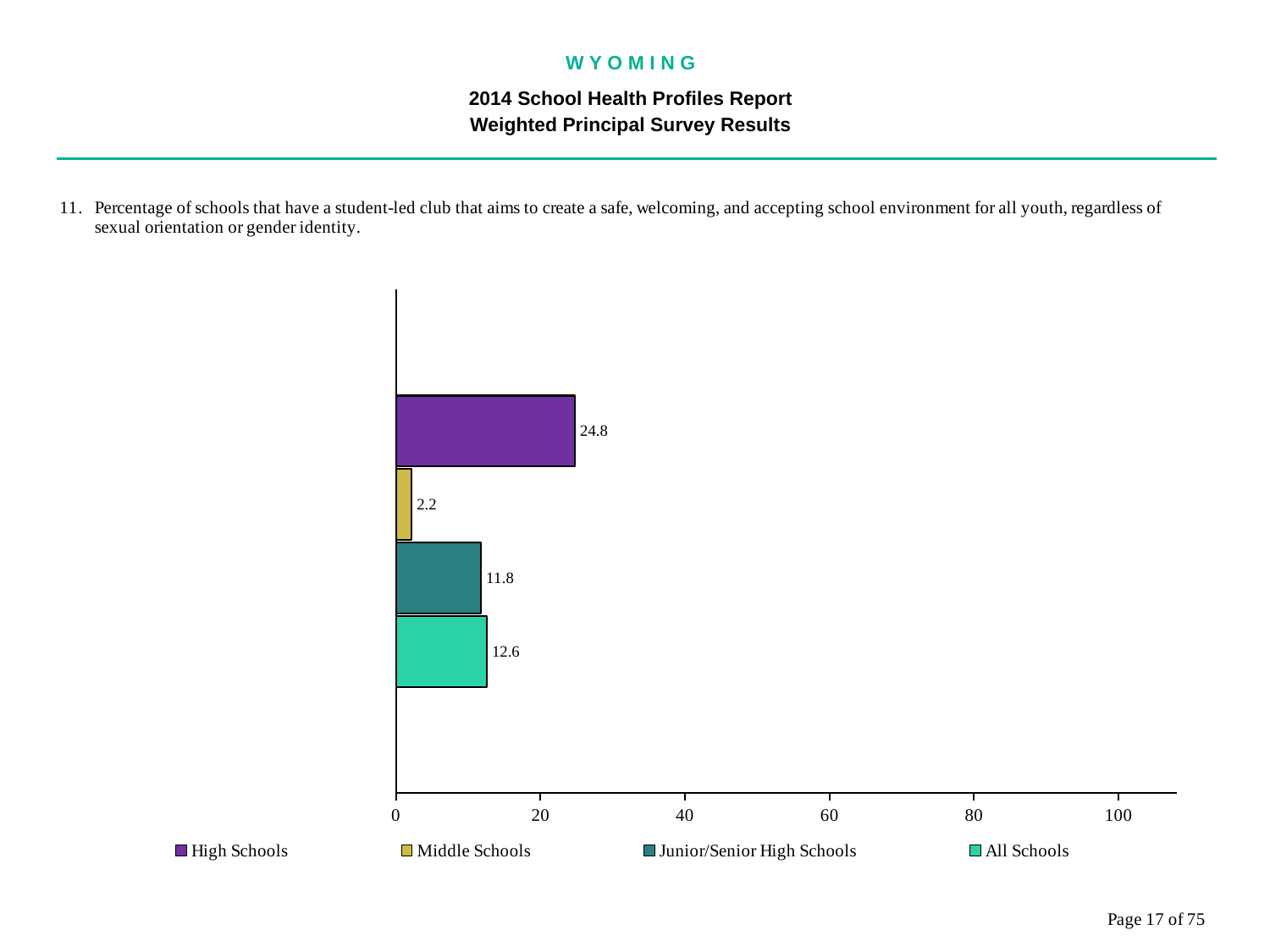
Which school type has the highest value? High Schools Is the value for High Schools greater or less than 20? greater What is the value for Junior/Senior High Schools? 11.8 What is the value for All Schools? 12.6 What is the value for High Schools? 24.8 What kind of chart is shown on the slide? bar chart What is the value for Middle Schools? 2.2 Which school type has the lowest value? Middle Schools How many series does the legend list? 4 What is the difference between the values for High Schools and Middle Schools? 22.6 Which is larger, the value for High Schools or the value for All Schools? High Schools What colour is the bar for Middle Schools? yellow